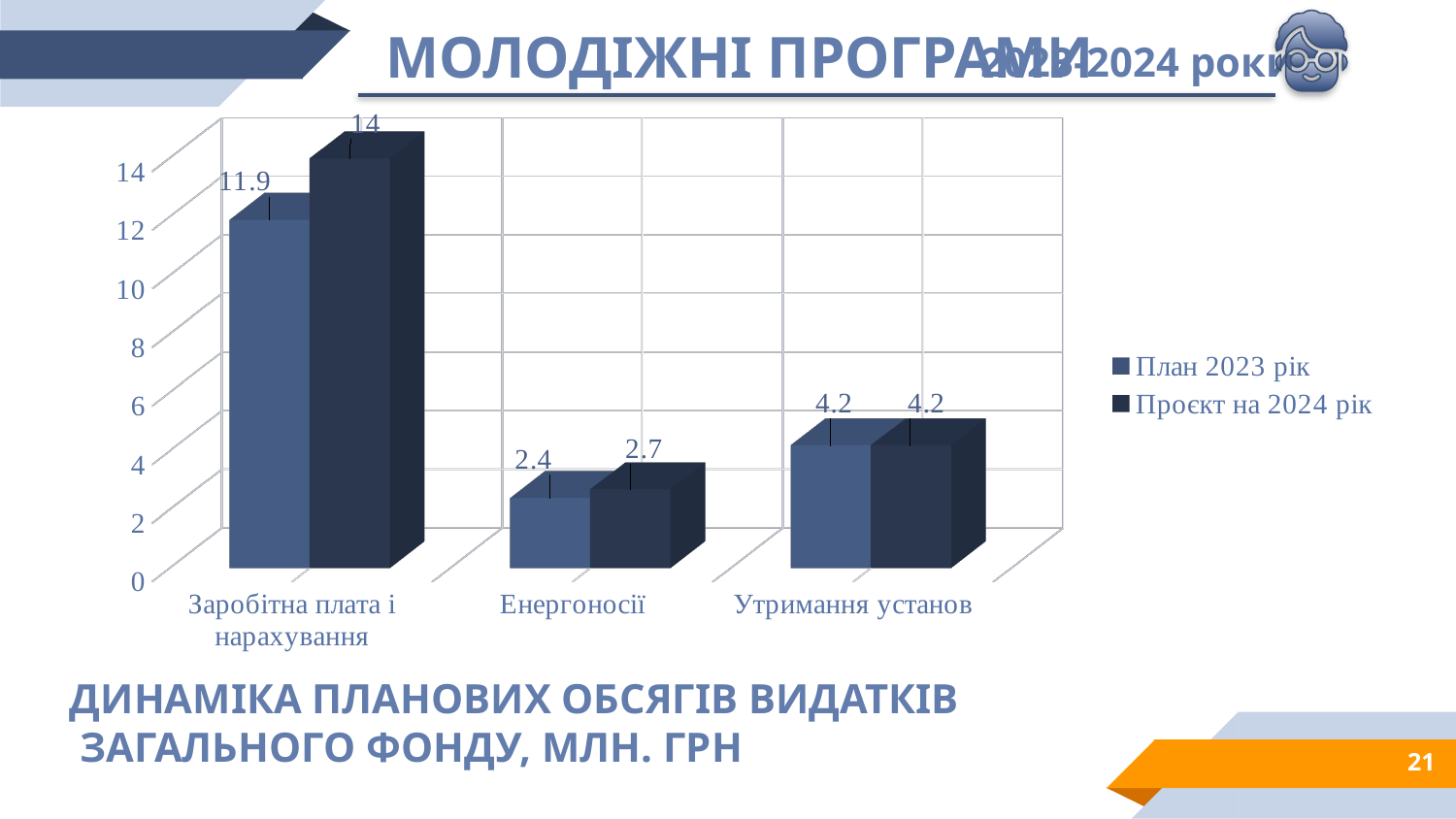
What is the value for "Заробітна плата і нарахування" in the "План 2023 рік" series? 11.9 What kind of chart is shown on the slide? Bar chart How many series does the chart legend list? 2 Which category has the lowest value in the "План 2023 рік" series? Енергоносії What are the two series names listed in the chart legend? План 2023 рік; Проєкт на 2024 рік How many categories are shown on the x axis of the chart? 3 What is the value for "Заробітна плата і нарахування" in the "Проєкт на 2024 рік" series? 14 What is the value for "Енергоносії" in the "Проєкт на 2024 рік" series? 2.7 What is the difference between the "Проєкт на 2024 рік" and "План 2023 рік" values for "Заробітна плата і нарахування"? 2.1 Which category has the highest value in the "Проєкт на 2024 рік" series? Заробітна плата і нарахування What is the value for "Утримання установ" in the "План 2023 рік" series? 4.2 Which is larger for "Енергоносії": the "План 2023 рік" value or the "Проєкт на 2024 рік" value? Проєкт на 2024 рік